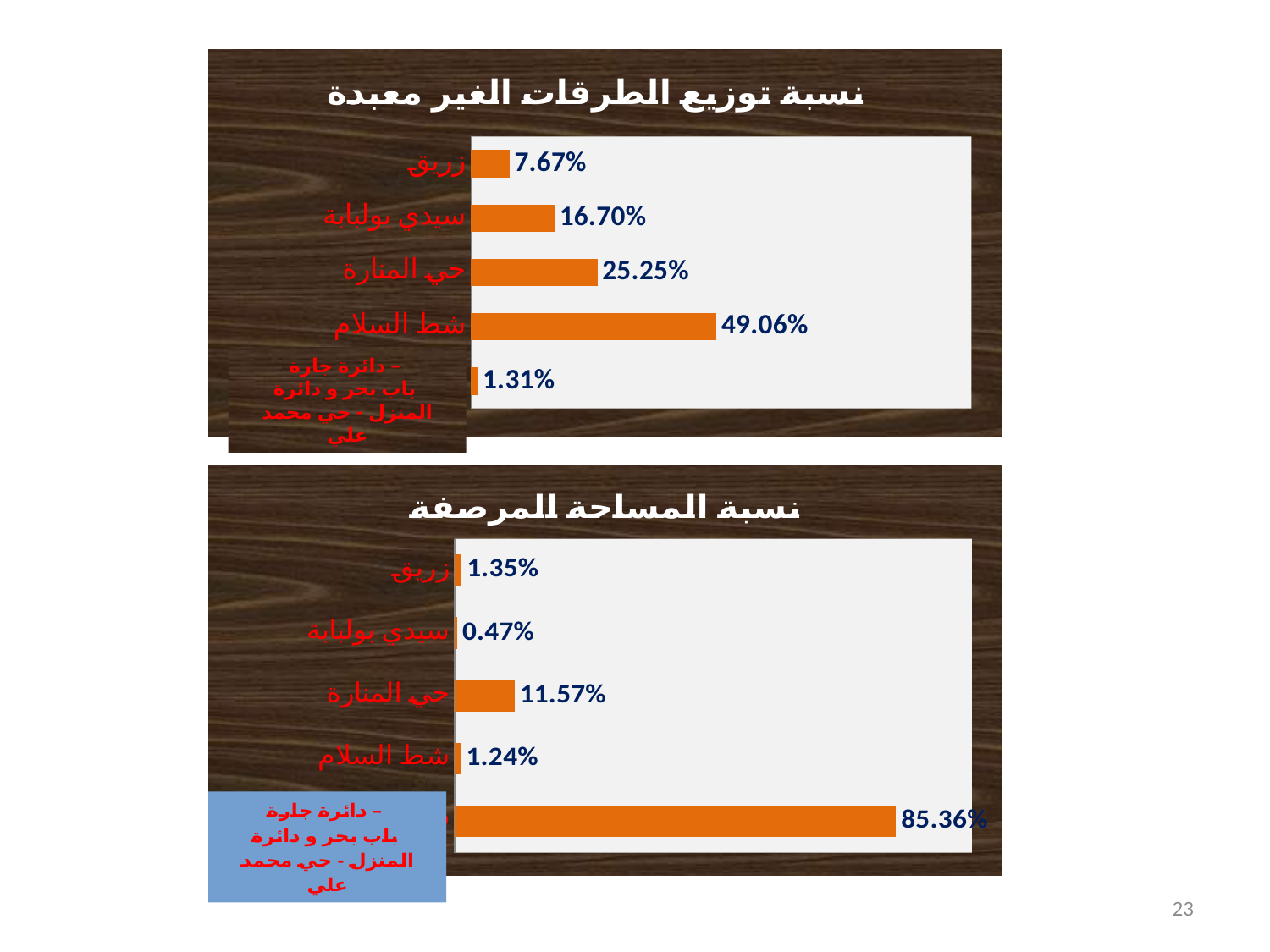
In the top chart, which category has the highest value? شط السلام What kind of chart is the bottom chart? bar chart In the top chart, what is the value for شط السلام? 49.06% In the top chart, how many categories are shown? 5 In the top chart, which category has the lowest value? دائرة جارة باب بحر و دائرة المنزل - حي محمد علي In the bottom chart, what is the value for سيدي بولبابة? 0.47% In the top chart, what is the value for سيدي بولبابة? 16.70% In the bottom chart, what is the value for حي المنارة? 11.57% In the top chart, what is the difference between the values for حي المنارة and زريق? 17.58% In the bottom chart, which is larger, the value for زريق or the value for شط السلام? زريق What is the title of the top chart? نسبة توزيع الطرقات الغير معبدة In the bottom chart, which category has the highest value? دائرة جارة باب بحر و دائرة المنزل - حي محمد علي